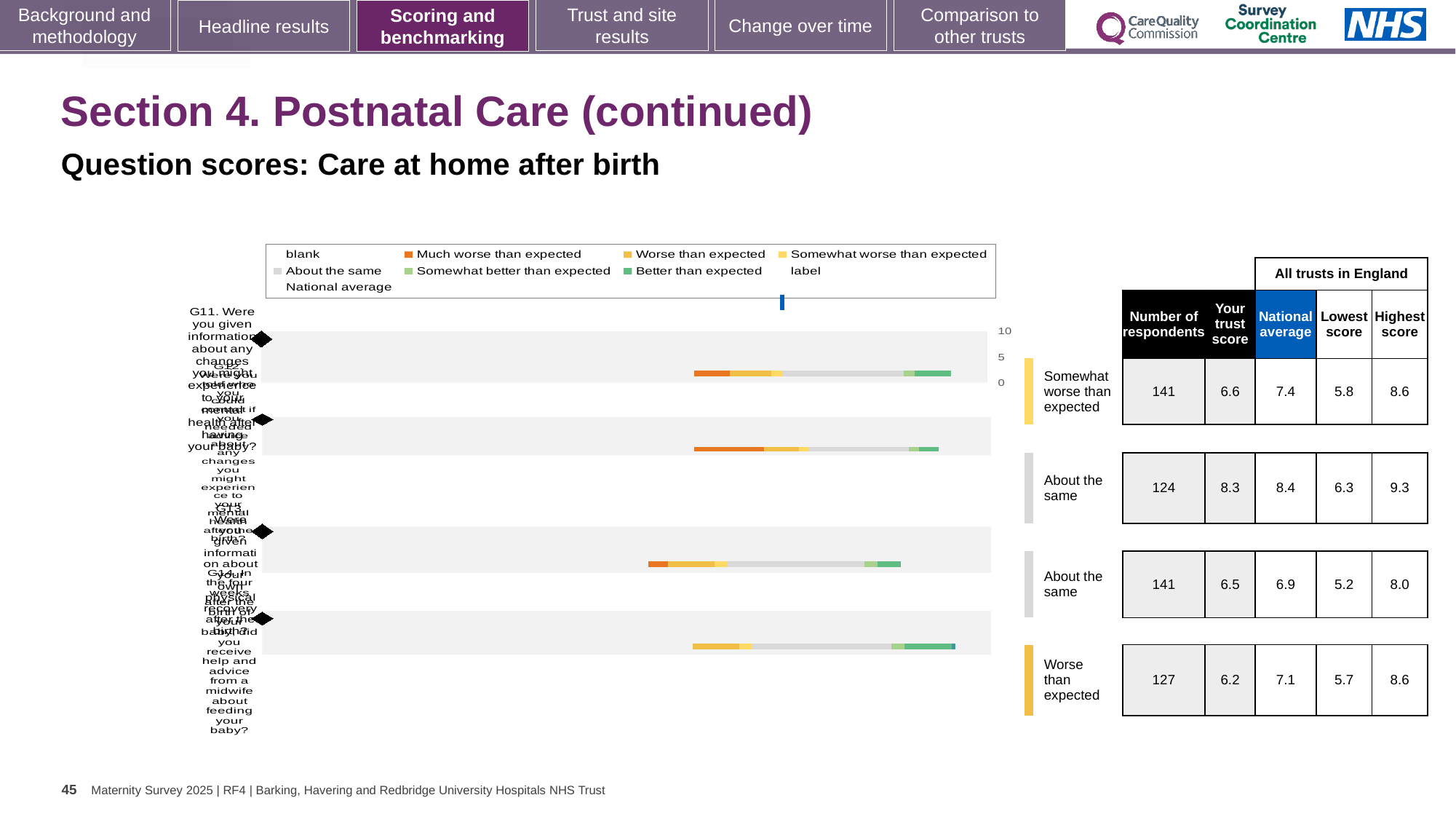
What is the national average for the top question row (G11)? 7.4 What colour does the legend use for 'Much worse than expected'? orange What is the highest score among all trusts in England for the second question row? 9.3 Which question row has the lowest 'Your trust score'? the fourth row (6.2) What rating label is shown next to the bottom (fourth) bar of the chart? Worse than expected How many respondents are listed for the second question row? 124 What kind of chart is shown on the slide? bar chart For the fourth question row, which is larger: the trust score or the national average? national average For the top question row (G11), what is the difference between the national average and the trust score? 0.8 How many question rows (bars) does the chart show? 4 What is the 'Your trust score' for the top question row (G11)? 6.6 Which question row has the highest 'Your trust score'? the second row (8.3)